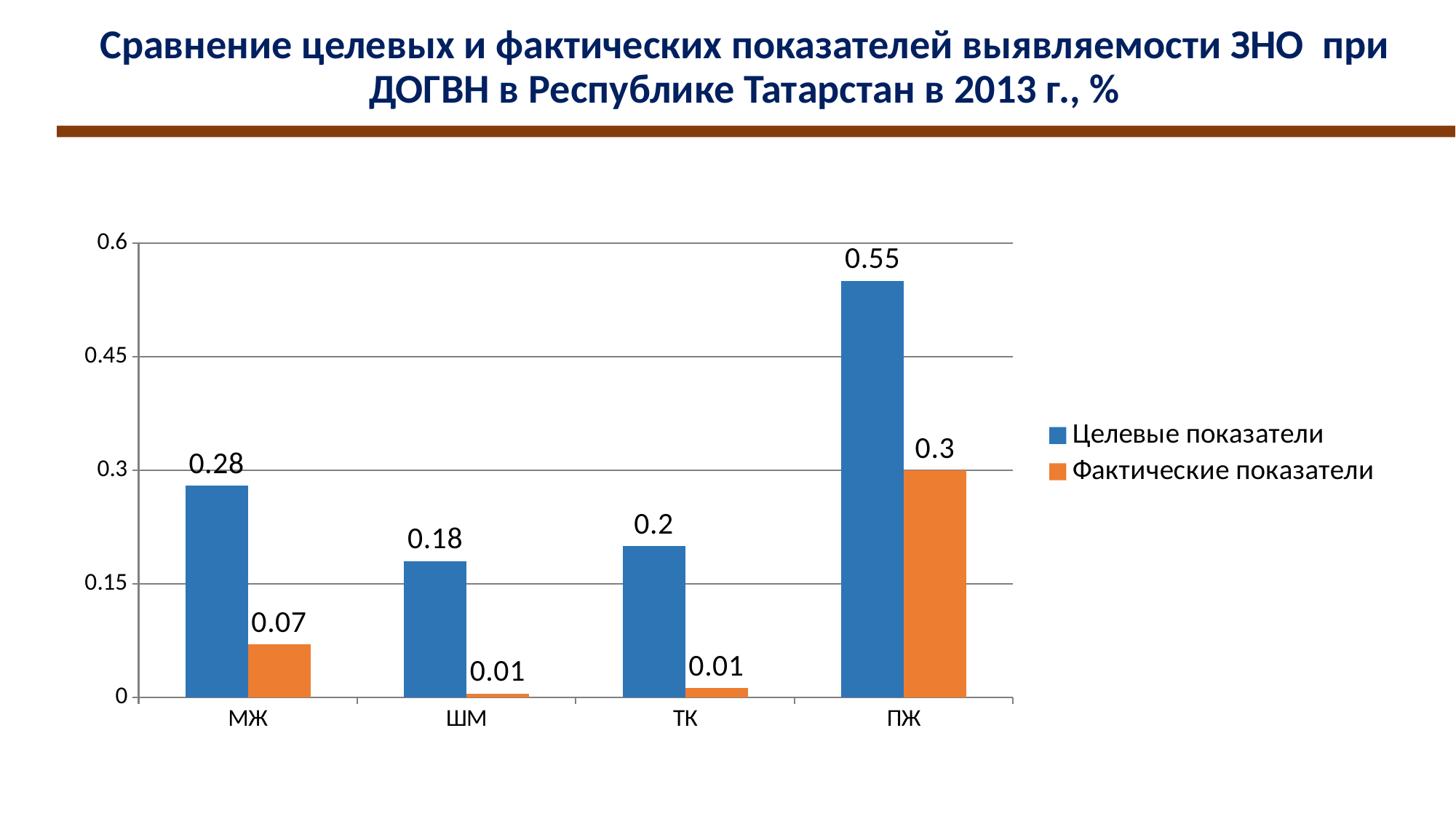
How many categories are shown on the x axis? 4 What is the value of Целевые показатели for ШМ? 0.18 Which is larger for ТК: Целевые показатели or Фактические показатели? Целевые показатели Which category has the lowest value for Целевые показатели? ШМ What is the value of Фактические показатели for МЖ? 0.07 Which category has the highest value for Целевые показатели? ПЖ How many series does the legend list? 2 What is the difference between the Целевые показатели and Фактические показатели values for ПЖ? 0.25 What is the value of Фактические показатели for ПЖ? 0.3 What kind of chart is shown on the slide? bar chart What is the value of Целевые показатели for ПЖ? 0.55 Is the value of Целевые показатели for МЖ greater or less than 0.3? less